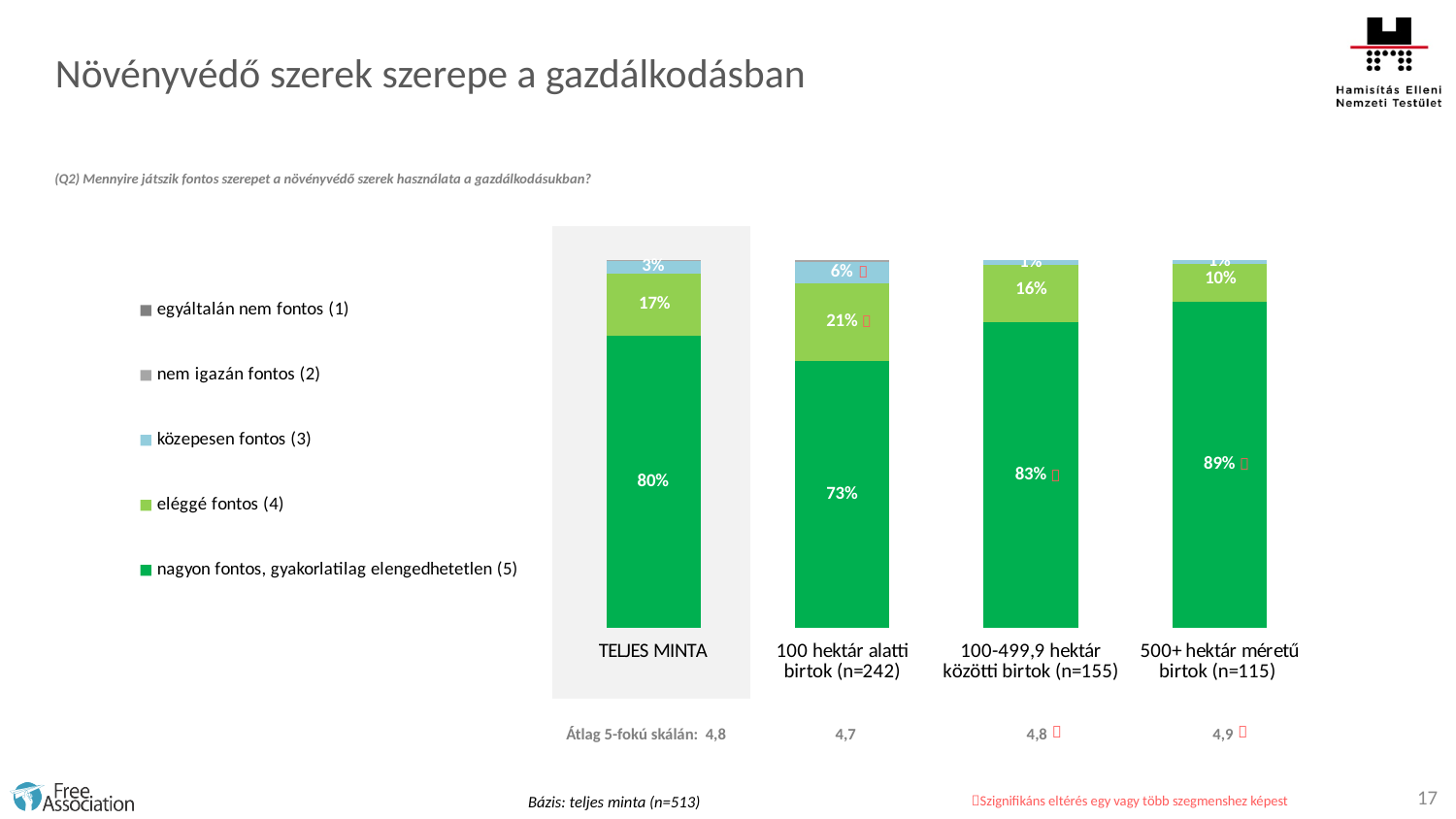
Which group has the lowest share of "nagyon fontos, gyakorlatilag elengedhetetlen (5)" answers? 100 hektár alatti birtok (n=242) How many groups (bars) are shown in the chart? 4 What type of chart is shown on the slide? Stacked bar chart Which group has the highest share of "nagyon fontos, gyakorlatilag elengedhetetlen (5)" answers? 500+ hektár méretű birtok (n=115) What percentage of the TELJES MINTA group answered "nagyon fontos, gyakorlatilag elengedhetetlen (5)"? 80% How many answer categories does the legend list? 5 What is the difference in the "nagyon fontos, gyakorlatilag elengedhetetlen (5)" share between the 500+ hektár méretű birtok group and the 100 hektár alatti birtok group? 16 percentage points What is the "eléggé fontos (4)" share for the 100 hektár alatti birtok (n=242) group? 21% What is the "közepesen fontos (3)" share for the TELJES MINTA group? 3% What is the "nagyon fontos, gyakorlatilag elengedhetetlen (5)" share for the 500+ hektár méretű birtok (n=115) group? 89% Which group has a larger "eléggé fontos (4)" share: 100-499,9 hektár közötti birtok or 500+ hektár méretű birtok? 100-499,9 hektár közötti birtok (n=155) What is the average on the 5-point scale (Átlag 5-fokú skálán) for the 500+ hektár méretű birtok group? 4,9